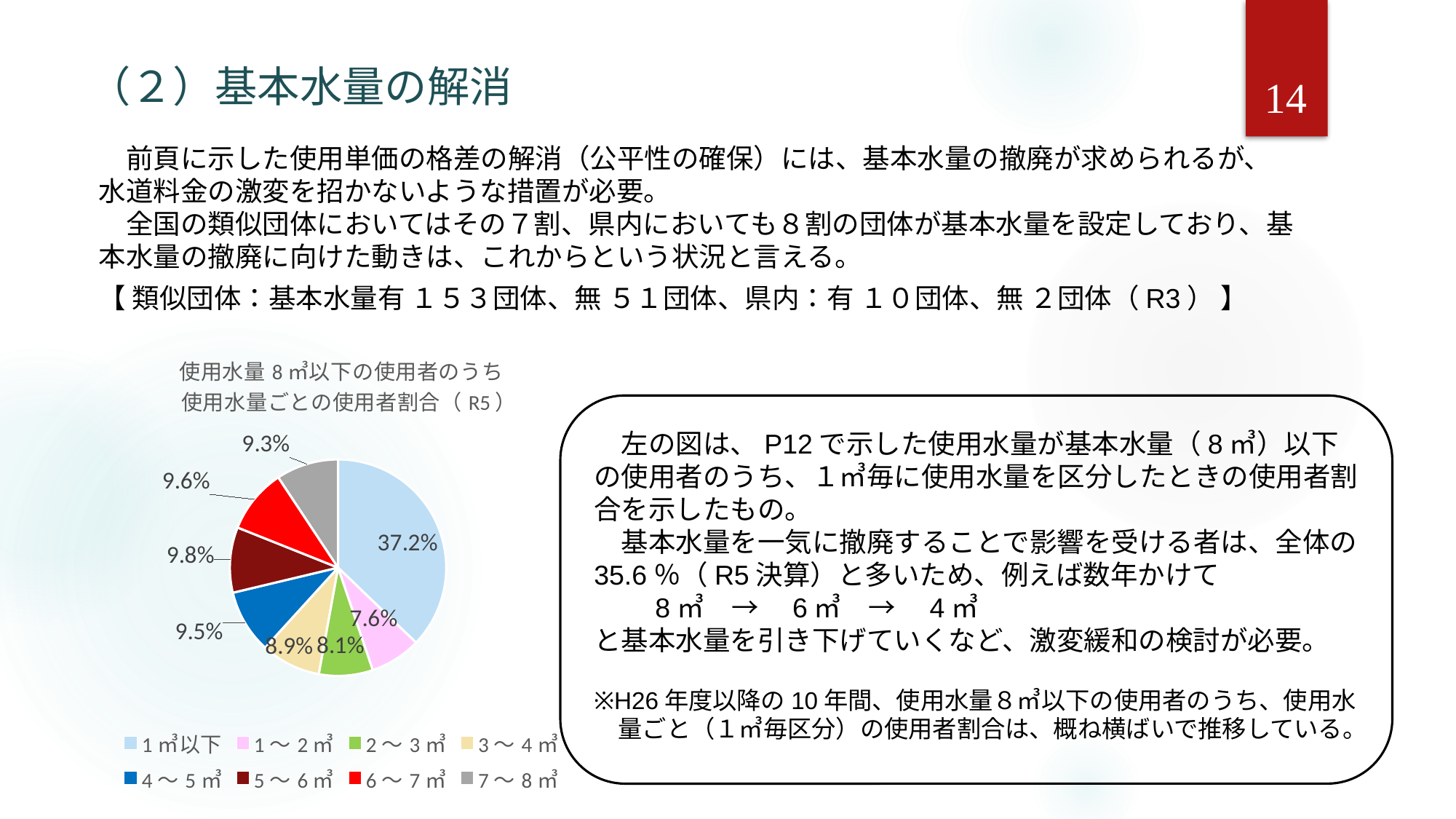
Which category has the smallest share of the pie? 1～2㎥ How many categories does the pie chart have? 8 What share of users does the 1㎥以下 slice represent? 37.2% What type of chart is shown on the slide? pie chart Which is larger, the share for 3～4㎥ or the share for 2～3㎥? 3～4㎥ What is the difference between the 1㎥以下 share and the 1～2㎥ share? 29.6% Which category has the largest share of the pie? 1㎥以下 What is the value for the 5～6㎥ category? 9.8% What is the value for the 1～2㎥ category? 7.6% What is the difference between the 4～5㎥ share and the 3～4㎥ share? 0.6% Which fiscal year is indicated in the chart title? R5 What is the value for the 7～8㎥ category? 9.3%